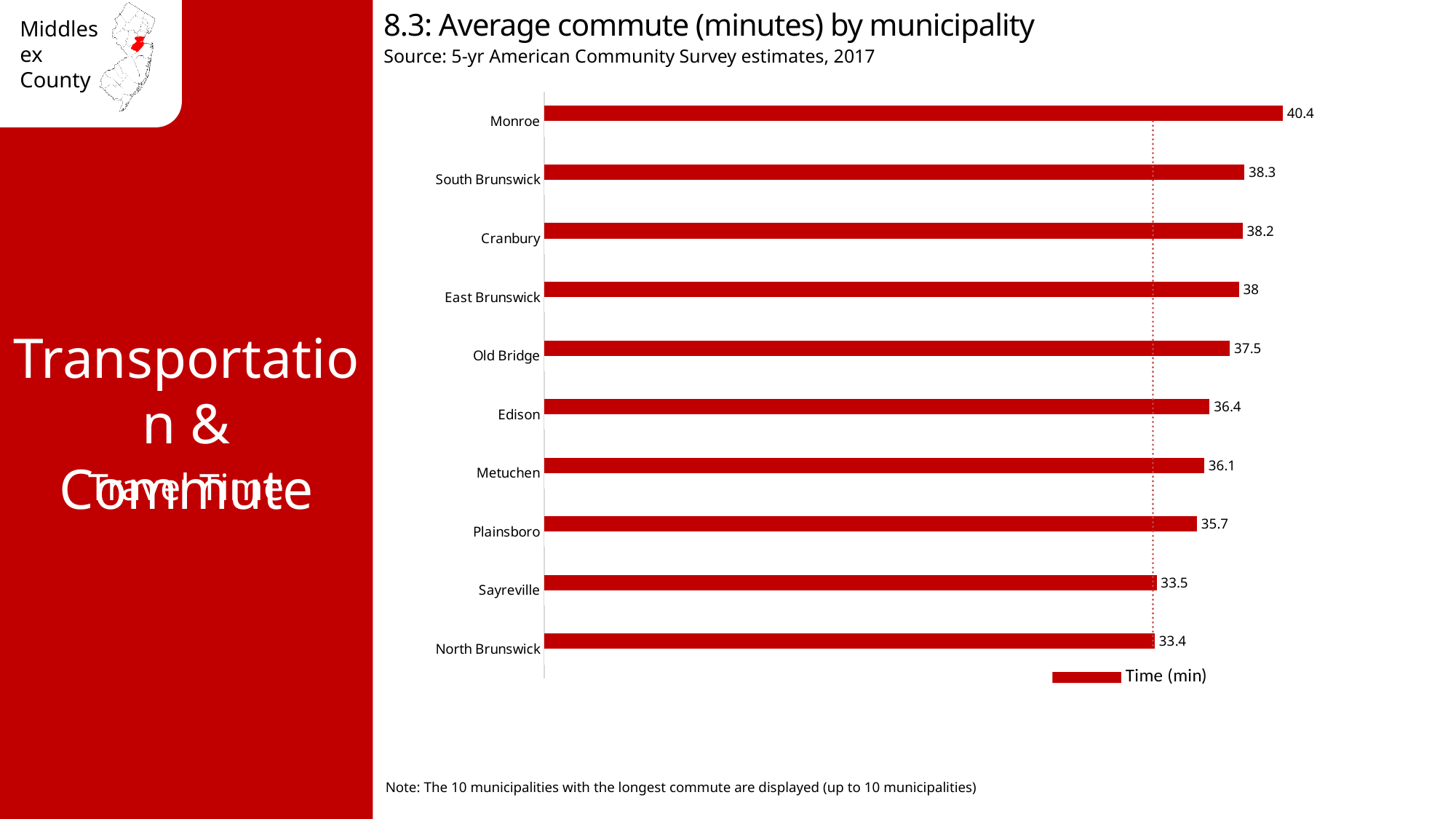
What is the average commute time for Monroe? 40.4 Which has a longer average commute, East Brunswick or Metuchen? East Brunswick Which municipality has the shortest average commute shown on the chart? North Brunswick What kind of chart is shown on the slide? Bar chart What is the difference in average commute time between Monroe and North Brunswick? 7 Which municipality has the longest average commute? Monroe What is the average commute time for Edison? 36.4 How many series does the legend list? 1 What is the average commute time for North Brunswick? 33.4 What is the legend entry for the series on the chart? Time (min) What is the difference in average commute time between Old Bridge and Plainsboro? 1.8 How many municipalities are shown on the chart? 10